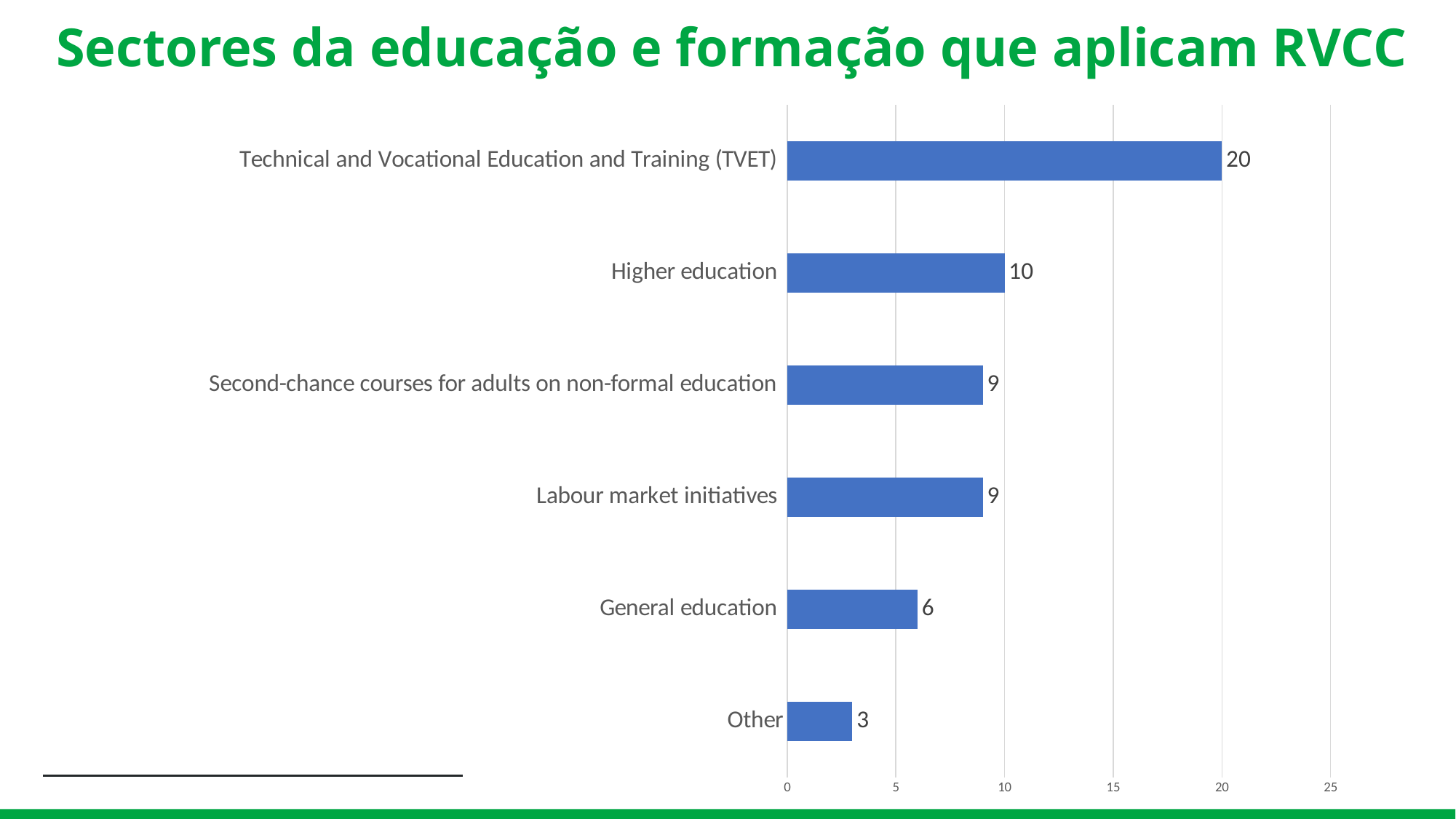
What is the difference between the values for TVET and Higher education? 10 What kind of chart is shown on the slide? Bar chart What is the difference between the values for General education and Other? 3 What is the value for Technical and Vocational Education and Training (TVET)? 20 Which category has the lowest value? Other Is the value for Second-chance courses for adults on non-formal education greater or less than 5? greater What is the value for Other? 3 What is the value for Higher education? 10 How many categories are shown in the chart? 6 Which is larger, the value for Higher education or the value for Labour market initiatives? Higher education What is the value for General education? 6 Which category has the highest value? Technical and Vocational Education and Training (TVET)